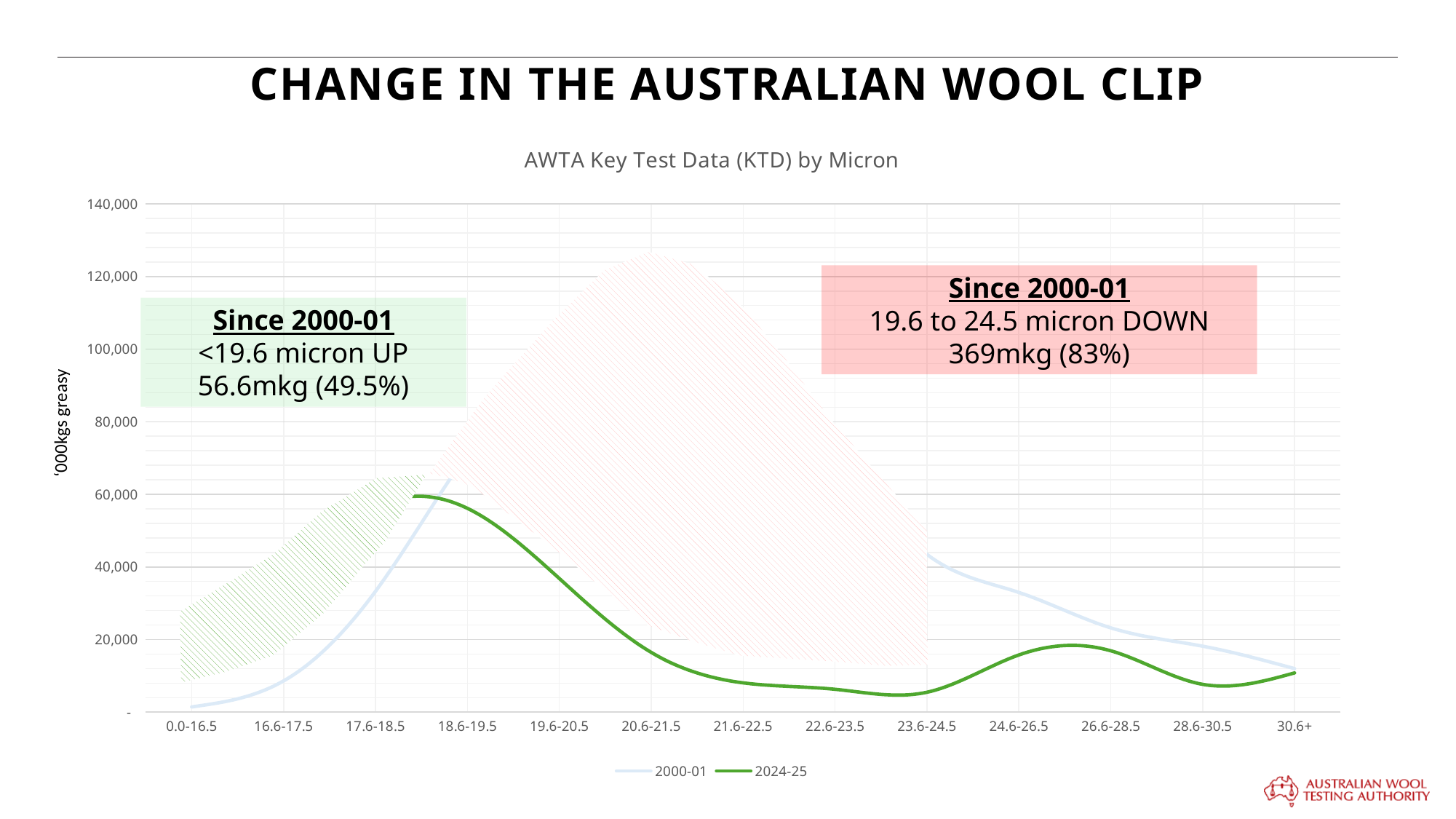
Is the 2024-25 value for 20.6-21.5 greater or less than 20,000? less In which micron category is the 2000-01 series at its lowest value? 0.0-16.5 Does the 2000-01 series rise or fall from 20.6-21.5 to 30.6+? fall What kind of chart is shown on the slide? line chart What is the title of the chart? AWTA Key Test Data (KTD) by Micron Which series has the higher value at 0.0-16.5, 2000-01 or 2024-25? 2024-25 Which series has the higher value at 20.6-21.5, 2000-01 or 2024-25? 2000-01 How many micron categories are shown on the x axis? 13 In which micron category does the 2000-01 series reach its highest value? 20.6-21.5 How many series does the chart legend list? 2